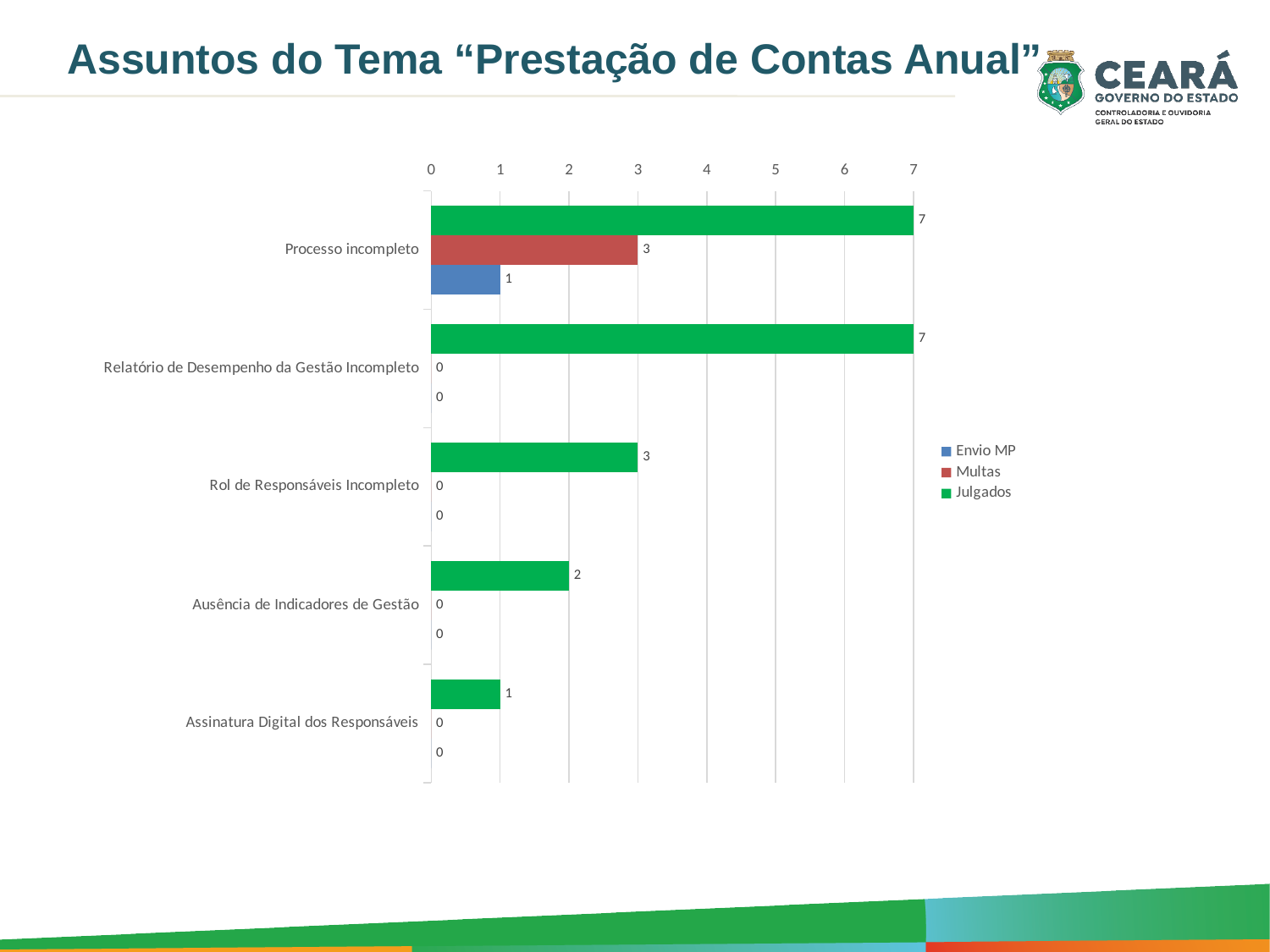
What is the Julgados value for Ausência de Indicadores de Gestão? 2 Which series is shown in green? Julgados What kind of chart is shown on the slide? Bar chart How many series does the legend list? 3 What is the difference between the Julgados values for Processo incompleto and Rol de Responsáveis Incompleto? 4 Which category has the lowest Julgados value? Assinatura Digital dos Responsáveis What is the Multas value for Processo incompleto? 3 Which is larger for Processo incompleto: the Multas value or the Envio MP value? Multas What is the Julgados value for Rol de Responsáveis Incompleto? 3 How many categories are shown on the chart? 5 What is the Envio MP value for Processo incompleto? 1 What is the Julgados value for Processo incompleto? 7